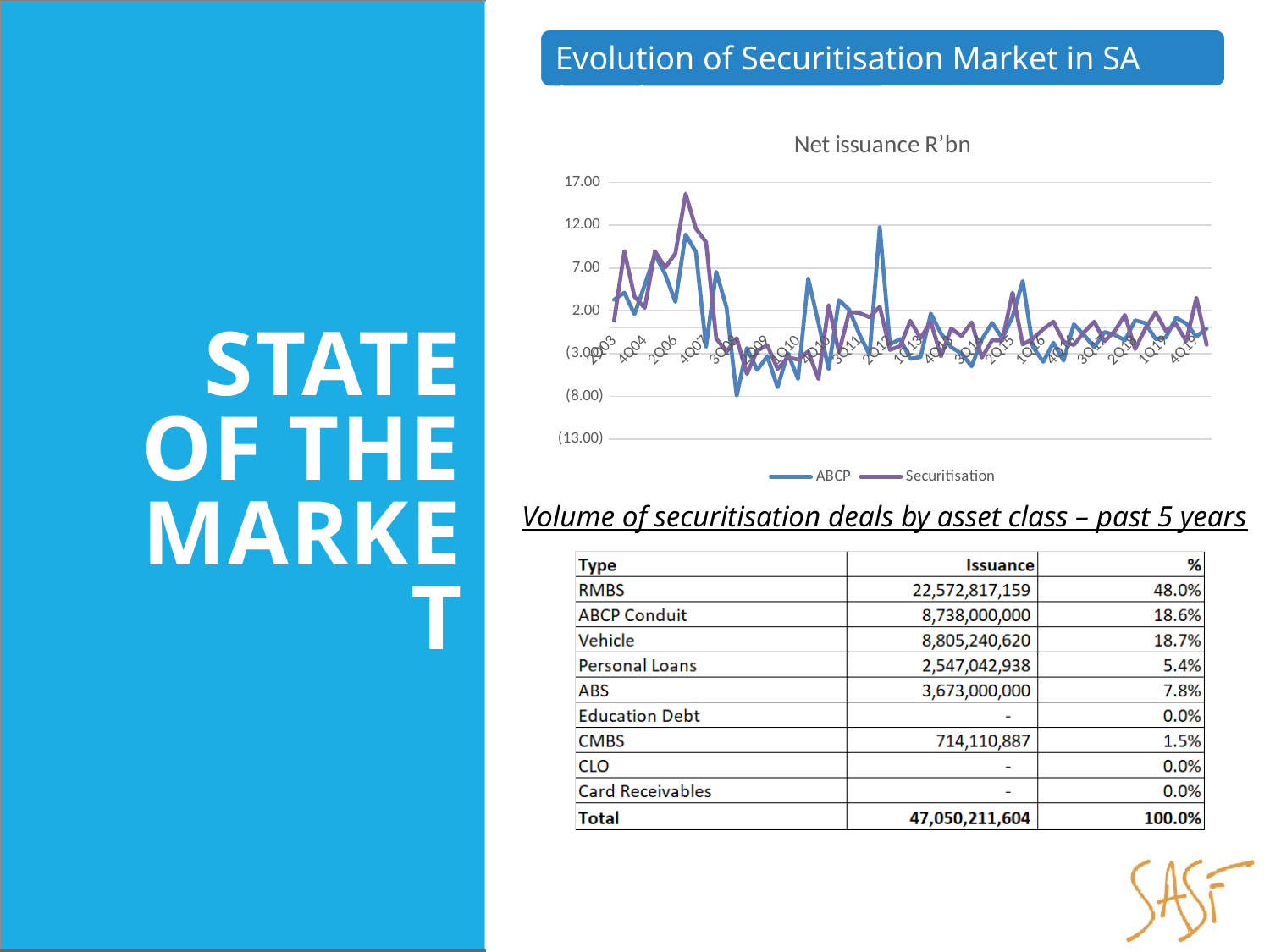
In the 'Net issuance R'bn' chart, is the highest value reached by the Securitisation series greater or less than 12.00? greater How many series does the legend of the 'Net issuance R'bn' chart list? 2 In the 'Net issuance R'bn' chart, which series reaches the higher peak value, ABCP or Securitisation? Securitisation In the 'Net issuance R'bn' chart, is the highest value reached by the ABCP series greater or less than 7.00? greater In the 'Net issuance R'bn' chart, is the Securitisation value at 4Q19 greater or less than 7.00? less What is the highest value shown on the y axis of the 'Net issuance R'bn' chart? 17.00 In the 'Net issuance R'bn' chart, does the Securitisation series rise or fall between 4Q07 and 3Q08? fall What kind of chart is the 'Net issuance R'bn' chart? line chart What is the title of the line chart on the slide? Net issuance R'bn What are the two series named in the legend of the 'Net issuance R'bn' chart? ABCP and Securitisation